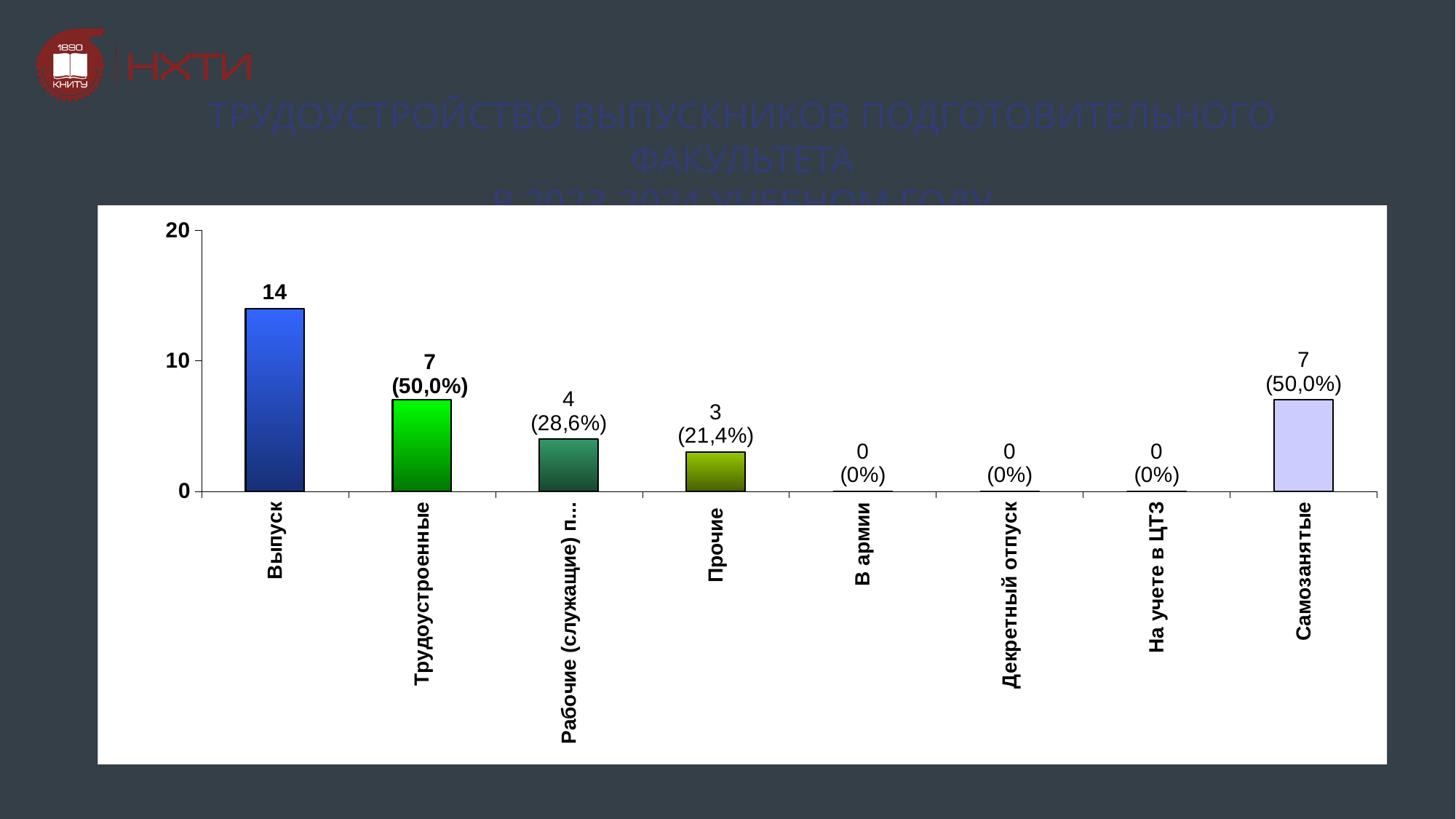
What is the value for Выпуск? 14 Is the value for Выпуск greater or less than 10? greater What is the value for Самозанятые? 7 Which category has the highest value? Выпуск Which is larger, the value for Трудоустроенные or the value for Прочие? Трудоустроенные How many categories are shown on the x axis? 8 What is the value for Прочие? 3 What is the value for Трудоустроенные? 7 What is the value for В армии? 0 What is the difference between the values for Выпуск and Трудоустроенные? 7 What kind of chart is shown on the slide? bar chart What percentage is shown for Прочие? 21,4%